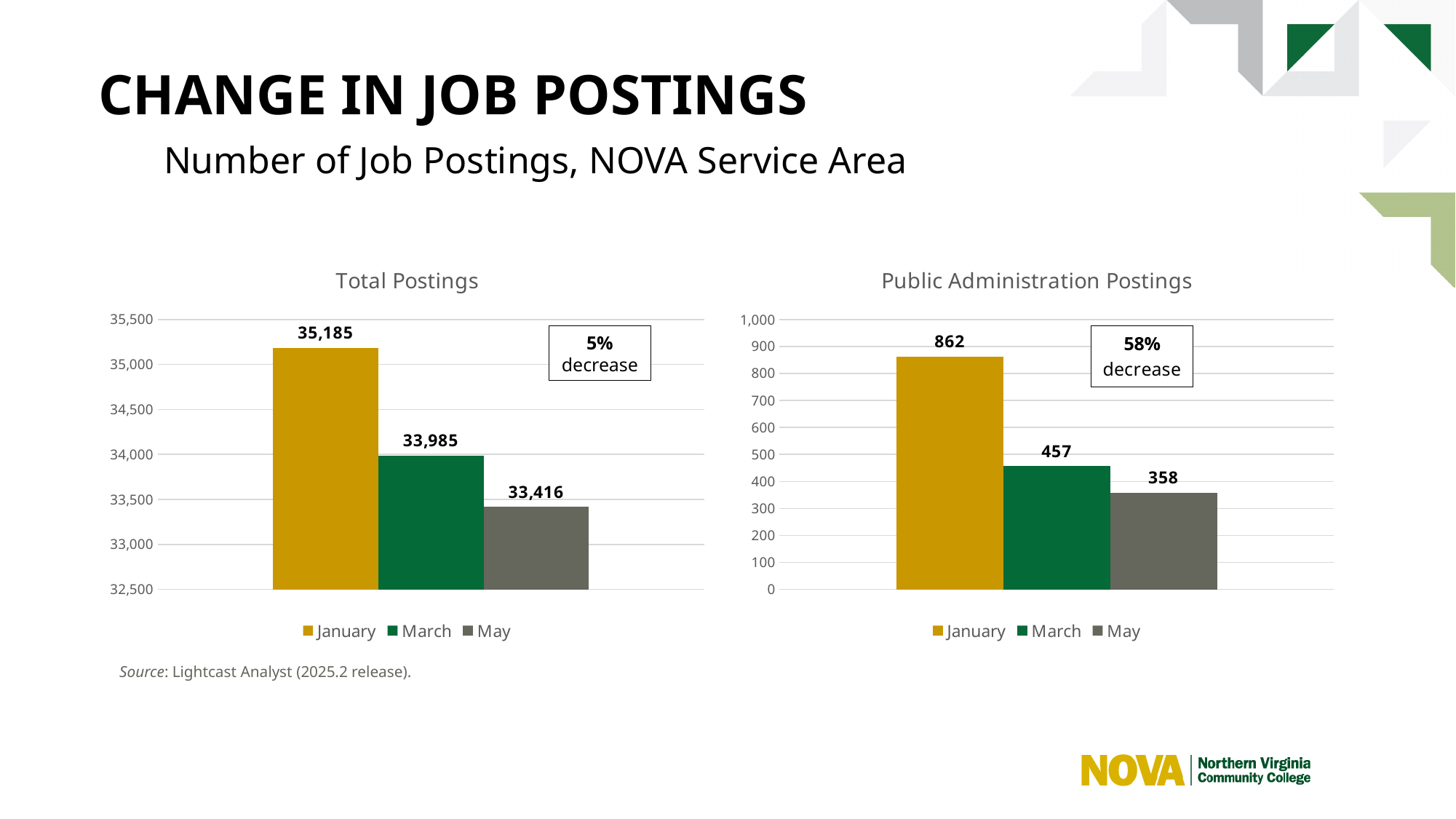
In the Total Postings chart, what is the value for January? 35,185 In the Public Administration Postings chart, is the value for March larger or smaller than the value for May? larger In the Public Administration Postings chart, what is the value for March? 457 In the Total Postings chart, which month has the lowest value? May In the Total Postings chart, is the value for March greater or less than 34,000? less In the Public Administration Postings chart, do the values rise or fall from January to May? fall How many series does the legend of the Public Administration Postings chart list? 3 In the Total Postings chart, what is the value for May? 33,416 In the Public Administration Postings chart, what is the difference between the January and May values? 504 What kind of chart is the Total Postings chart? bar chart In the Public Administration Postings chart, which month has the highest value? January In the Total Postings chart, what is the difference between the January and March values? 1,200